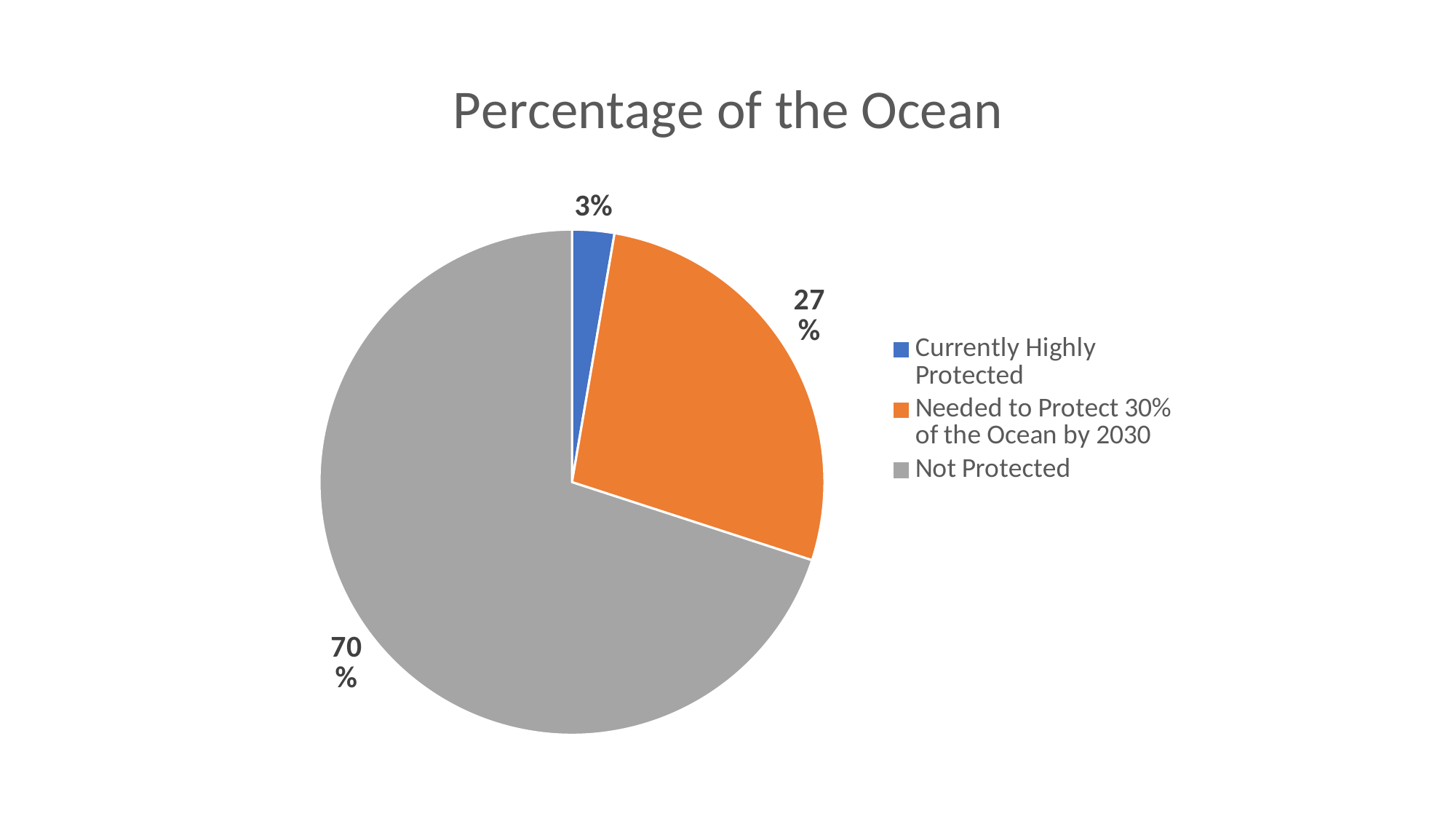
How many entries does the legend list? 3 What percentage of the ocean is Not Protected? 70% Which category has the smallest slice of the pie? Currently Highly Protected What percentage is labelled Needed to Protect 30% of the Ocean by 2030? 27% Which is larger, the Currently Highly Protected slice or the Needed to Protect 30% of the Ocean by 2030 slice? Needed to Protect 30% of the Ocean by 2030 What is the difference between the Not Protected share and the Needed to Protect 30% of the Ocean by 2030 share? 43% What percentage of the ocean is Currently Highly Protected? 3% What is the title of the chart? Percentage of the Ocean How many slices does the pie chart have? 3 What colour is the Not Protected slice? grey What kind of chart is shown on the slide? pie chart Which category has the largest slice of the pie? Not Protected